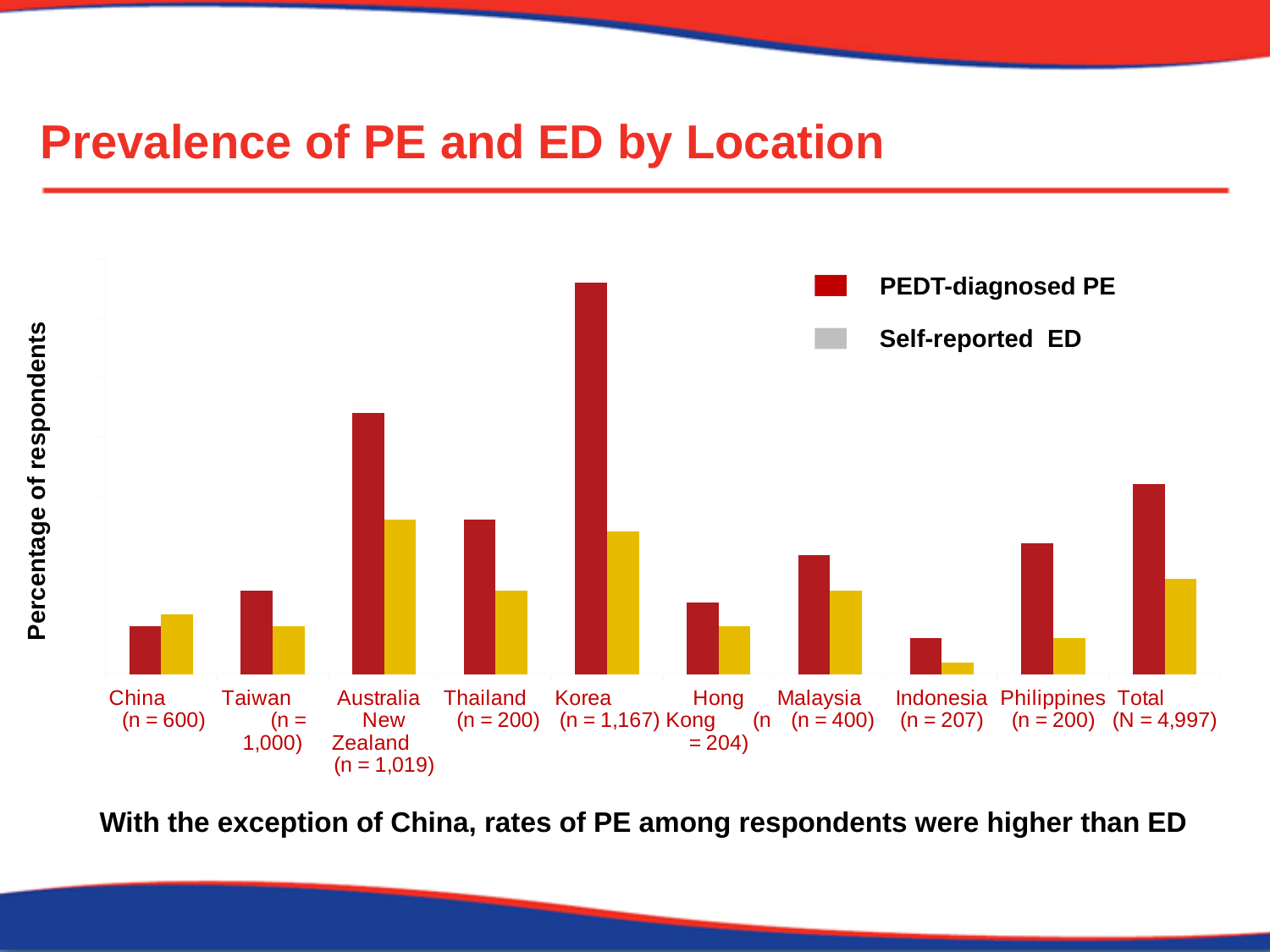
What kind of chart is shown on the slide? bar chart What is the label on the y axis? Percentage of respondents Which is larger for China: PEDT-diagnosed PE or Self-reported ED? Self-reported ED Which location has the larger PEDT-diagnosed PE value: Indonesia or Philippines? Philippines Which location has the larger Self-reported ED value: Korea or Hong Kong? Korea How many series does the legend list? 2 What is the title of the slide's chart? Prevalence of PE and ED by Location Which location has the highest PEDT-diagnosed PE bar? Korea Which location has the lowest Self-reported ED bar? Indonesia How many location categories are shown on the x axis? 10